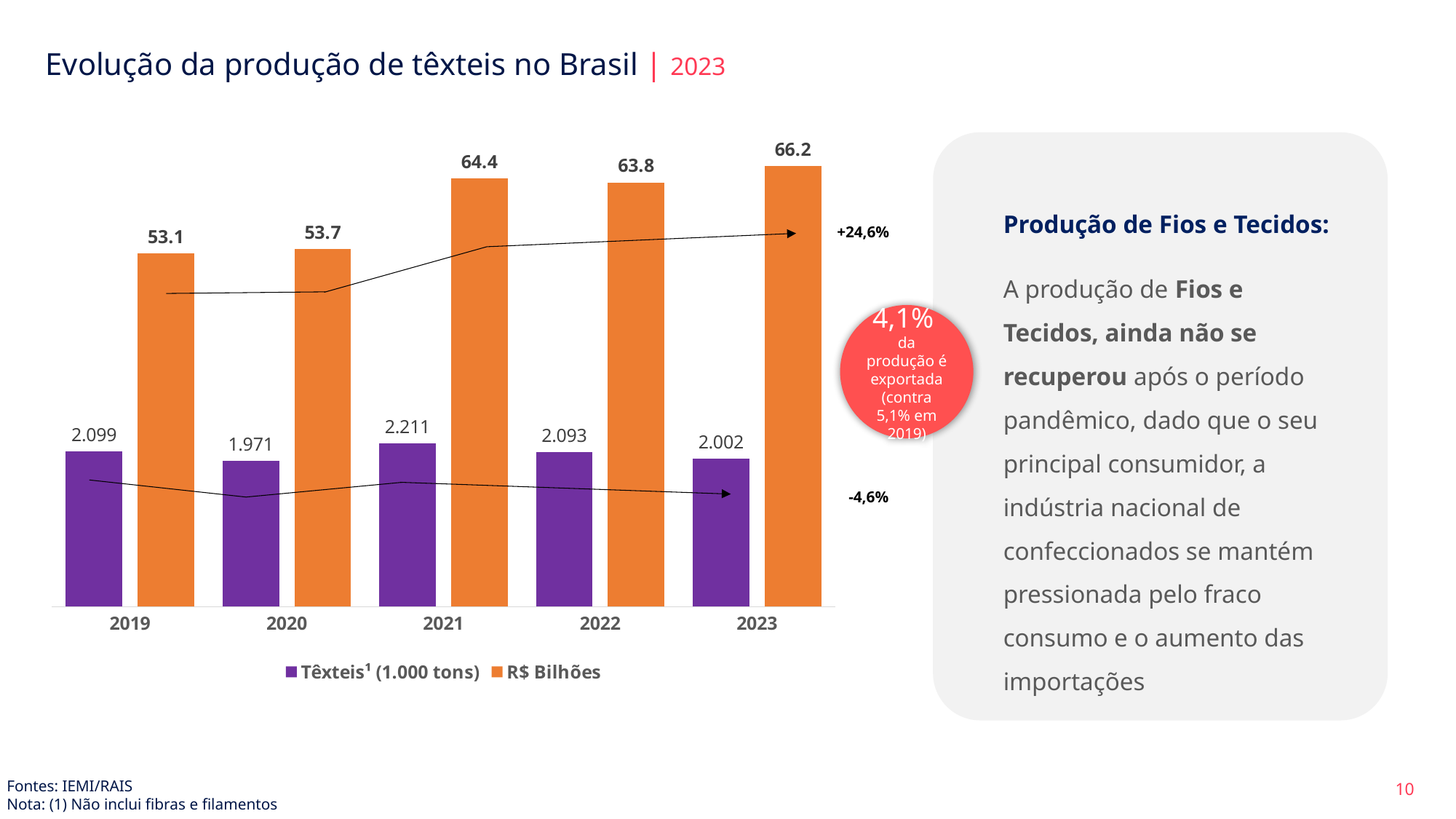
What is the R$ Bilhões value for 2021? 64.4 How many series does the chart legend list? 2 How many years are shown on the x axis of the chart? 5 What kind of chart is shown on the slide? Bar chart What is the difference between the R$ Bilhões values for 2023 and 2019? 13.1 What colour are the R$ Bilhões bars? Orange Which year has the highest R$ Bilhões value? 2023 Which year has the highest Têxteis (1.000 tons) value? 2021 Which is larger, the R$ Bilhões value for 2021 or for 2022? 2021 Which year has the lowest Têxteis (1.000 tons) value? 2020 What is the Têxteis (1.000 tons) value for 2020? 1.971 What is the R$ Bilhões value for 2023? 66.2